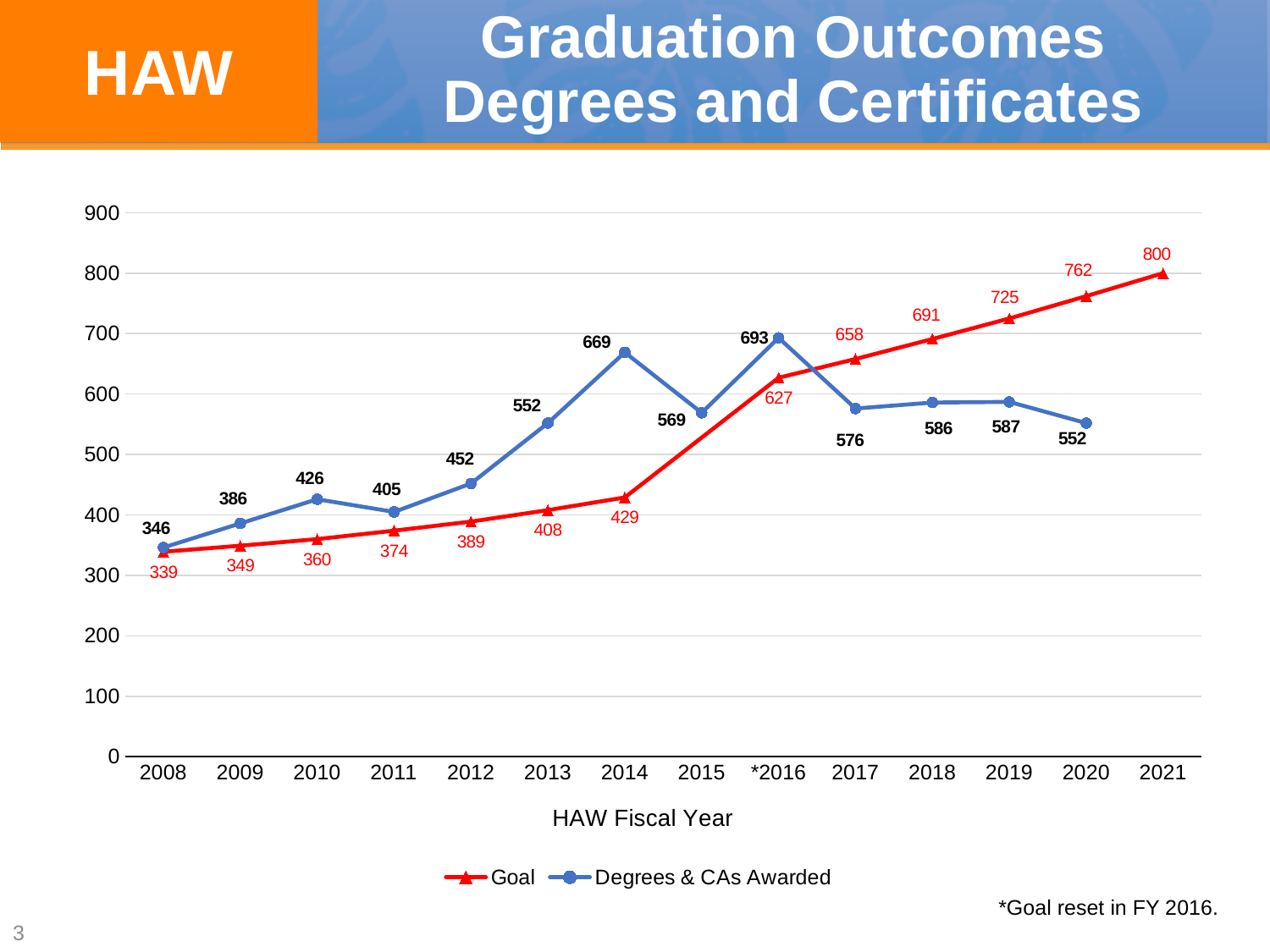
What is the Goal value for 2021? 800 By how much did Degrees & CAs Awarded exceed the Goal in *2016? 66 What kind of chart is shown on the slide? Line chart What is the difference between the Goal and Degrees & CAs Awarded in 2020? 210 How many fiscal years are shown on the x axis? 14 In 2013, which is larger: the Goal or Degrees & CAs Awarded? Degrees & CAs Awarded In 2017, which is larger: the Goal or Degrees & CAs Awarded? Goal In which fiscal year is the Degrees & CAs Awarded value lowest? 2008 How many series does the legend list? 2 What is the value of Degrees & CAs Awarded in 2014? 669 What is the Goal value for 2008? 339 In which fiscal year is the Degrees & CAs Awarded value highest? *2016